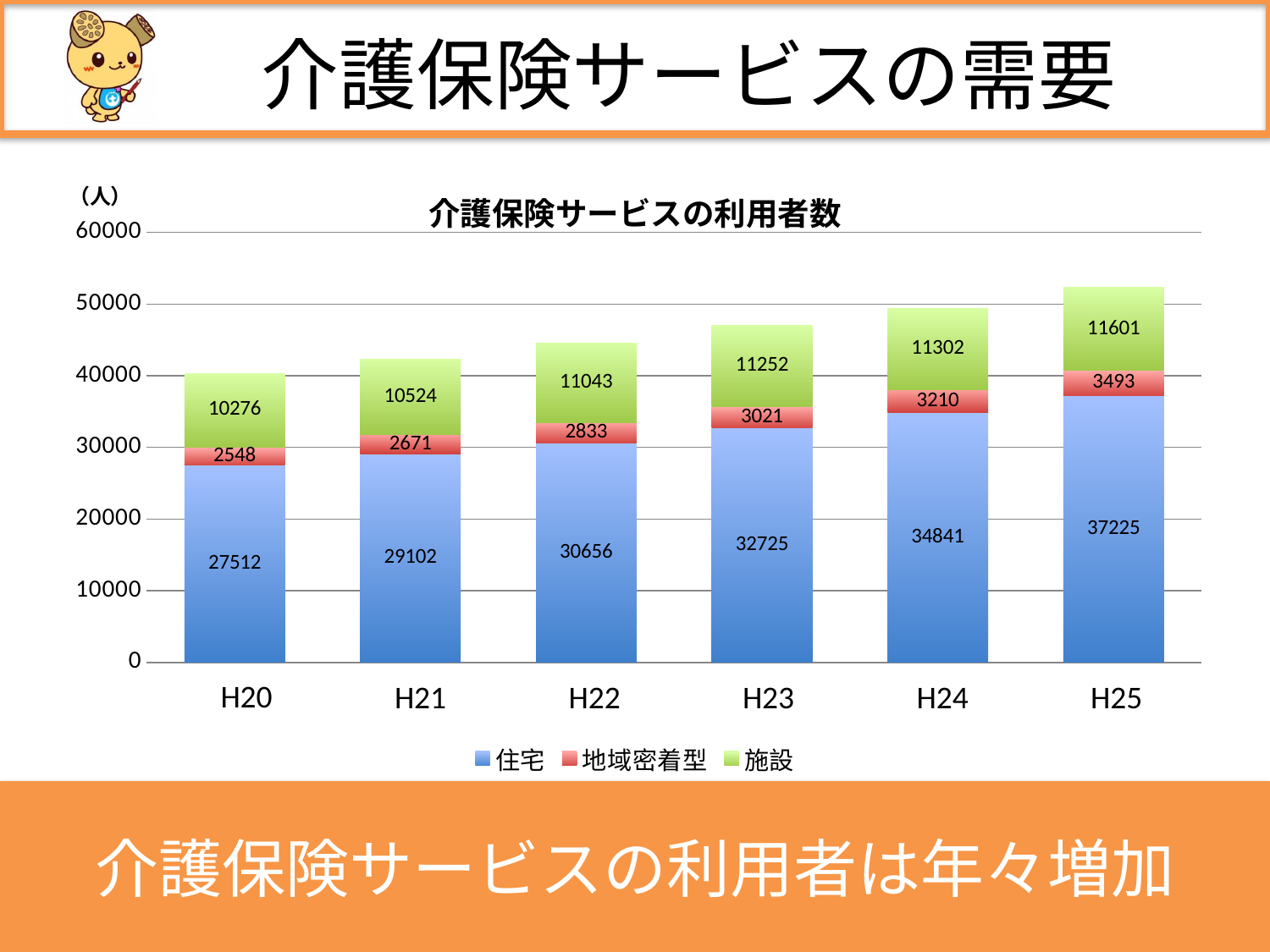
Which year has the highest value for 住宅? H25 What is the value of 施設 for H20? 10276 What is the total of the stacked bar for H20? 40336 What is the total of the stacked bar for H25? 52319 Do the 住宅 values rise or fall from H20 to H25? rise How many years are shown on the x axis? 6 What is the difference between the 住宅 values for H25 and H20? 9713 Which year has the lowest value for 施設? H20 Which is larger, the 地域密着型 value for H23 or for H21? H23 What is the value of 住宅 for H22? 30656 How many series does the legend list? 3 What is the value of 地域密着型 for H25? 3493